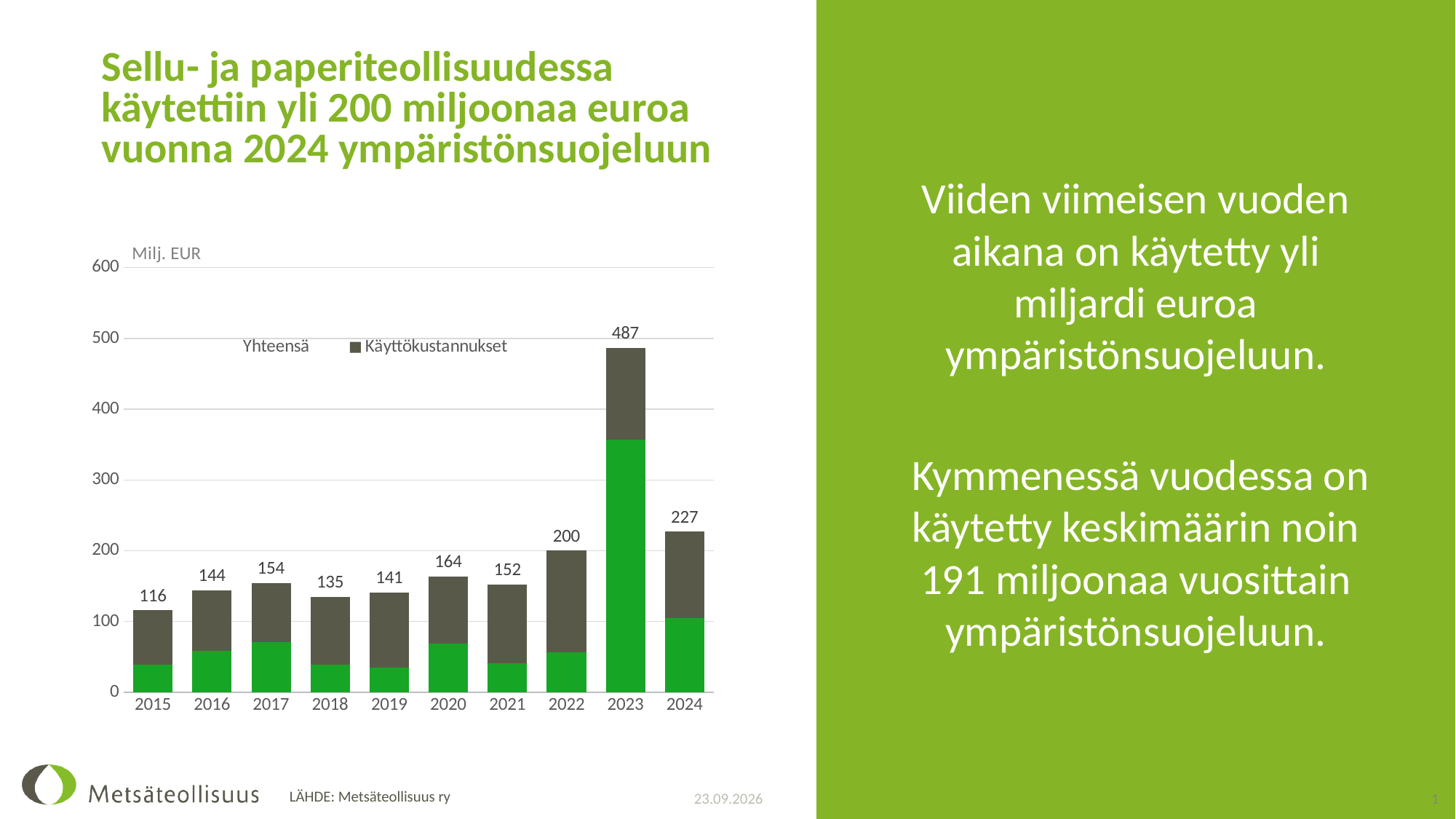
What is the total value shown for 2015? 116 What is the total value shown for 2022? 200 What is the difference between the total for 2023 and the total for 2024? 260 Is the Käyttökustannukset (dark) segment for 2023 greater or less than 100? greater What kind of chart is shown on the slide? stacked bar chart What is the total value shown for 2024? 227 What unit is shown above the y axis of the chart? Milj. EUR Which year has the highest total value? 2023 Is the green segment for 2017 greater or less than 100? less Which year has a larger total, 2017 or 2018? 2017 Which year has the lowest total value? 2015 How many years are shown on the x axis? 10